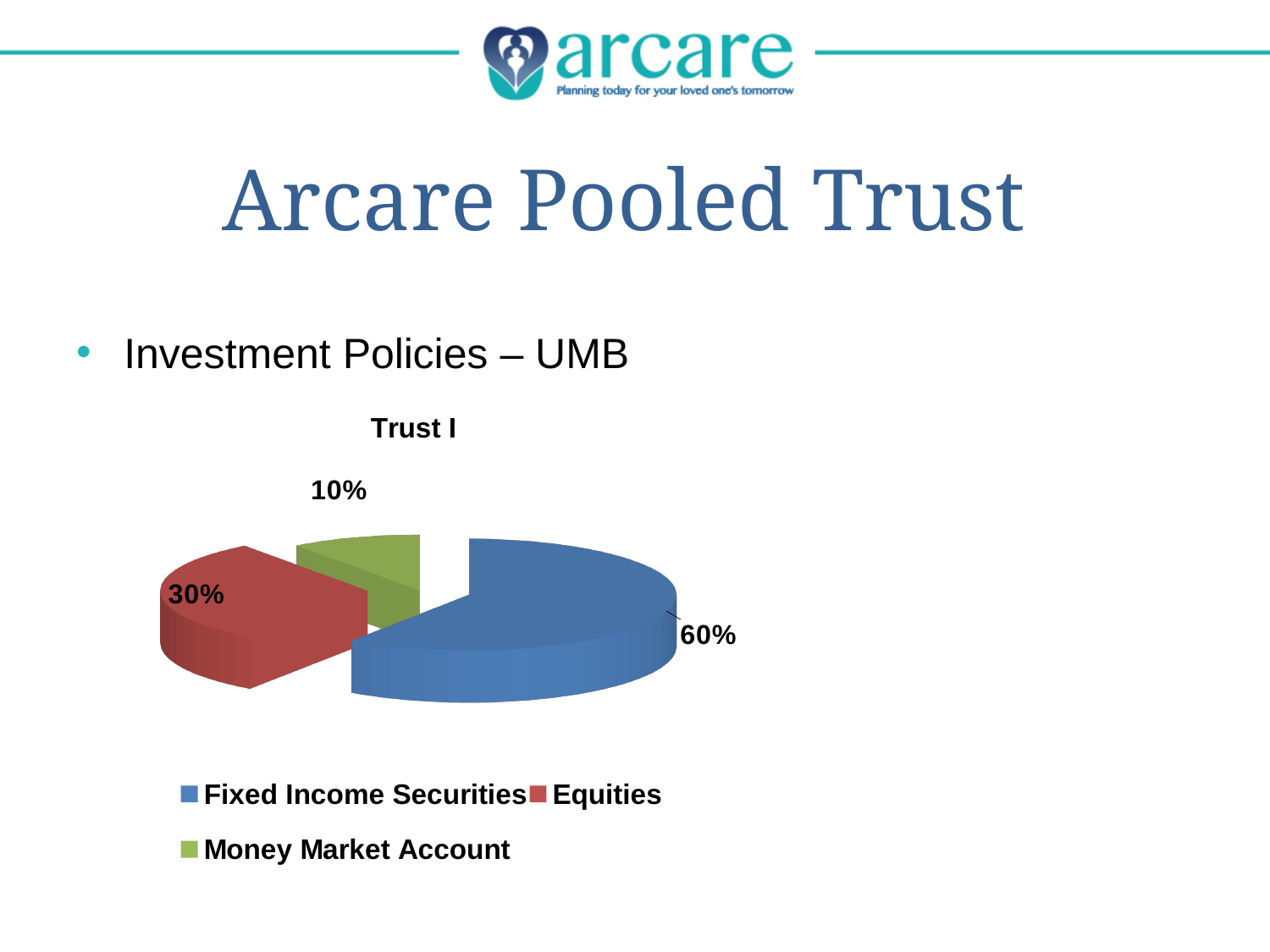
How many categories does the pie chart have? 3 What is the title of the chart? Trust I Which category has the smallest share of the pie? Money Market Account What colour is the Equities slice? Red What share of the pie is Equities? 30% What share of the pie is Money Market Account? 10% What is the difference between the Fixed Income Securities share and the Equities share? 30% What type of chart is shown on the slide? Pie chart Which is larger, the Equities share or the Money Market Account share? Equities How many entries does the legend list? 3 What share of the pie is Fixed Income Securities? 60% Which category has the largest share of the pie? Fixed Income Securities